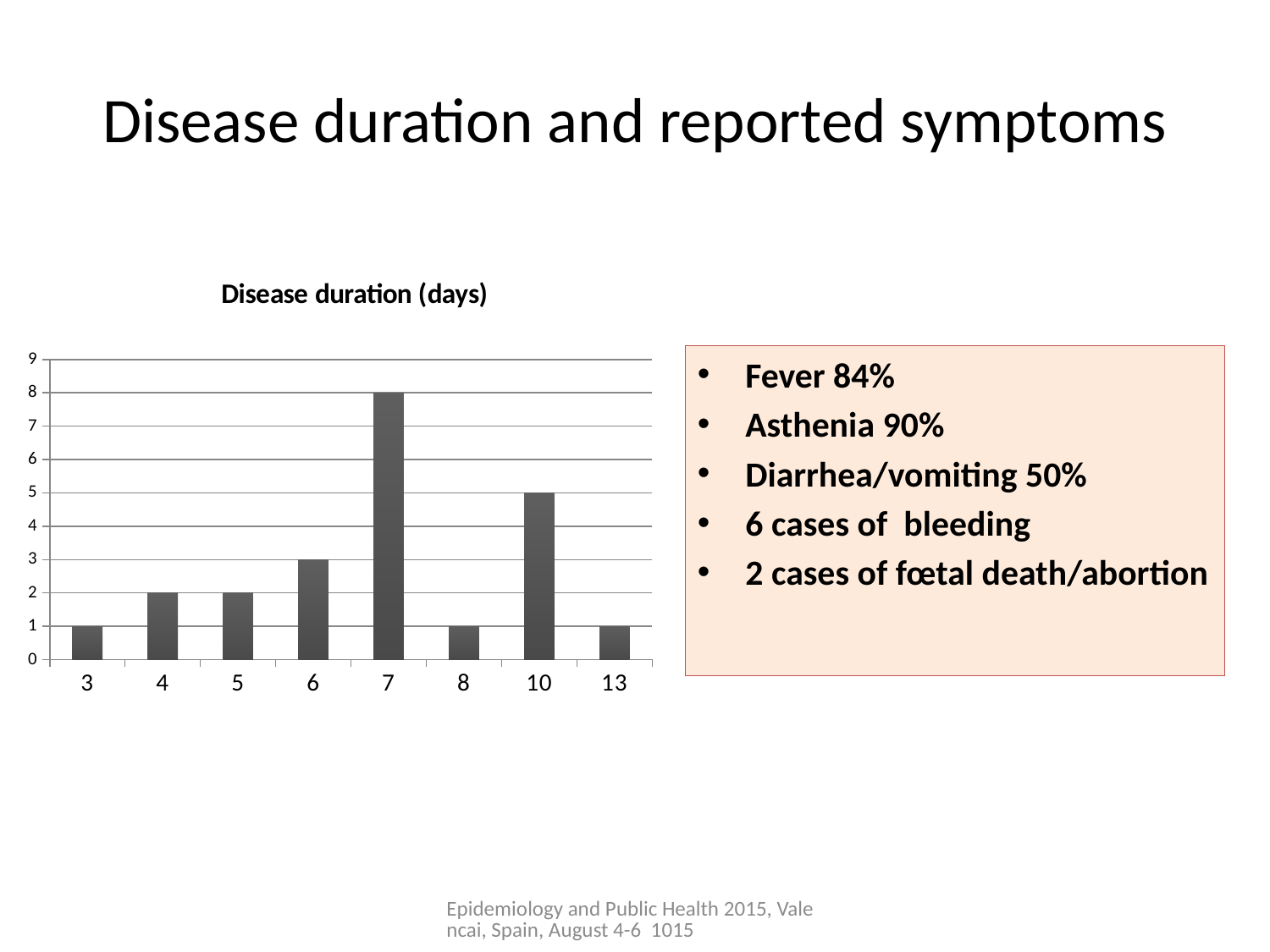
Which disease duration has the highest number of cases? 7 Is the value for 7 days greater or less than 5? greater What is the highest value shown on the y axis of the chart? 9 Which is larger, the value for 6 days or the value for 8 days? 6 days How many categories are shown on the x axis of the chart? 8 What is the value for a disease duration of 7 days? 8 What is the value for a disease duration of 13 days? 1 What is the title of the chart? Disease duration (days) What is the value for a disease duration of 10 days? 5 What kind of chart is shown on the slide? bar chart What is the difference between the values for 7 days and 10 days? 3 What is the value for a disease duration of 6 days? 3